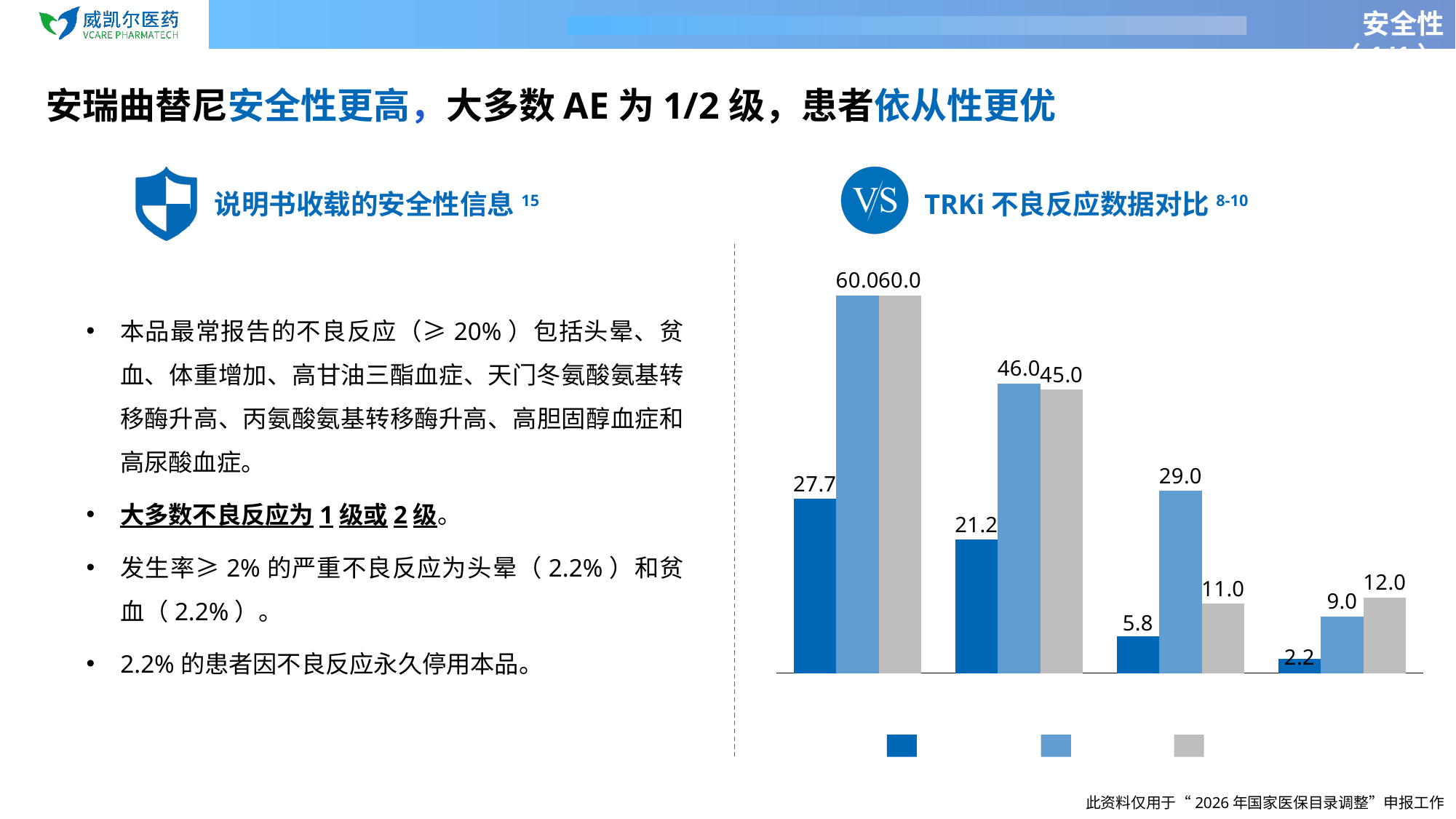
What is the difference between the light blue bar and the dark blue bar in the second group? 24.8 What is the title of the chart on the right side of the slide? TRKi 不良反应数据对比 How many series does the chart's legend list? 3 What is the value of the light blue bar in the third group? 29.0 Which group has the highest dark blue bar? the first (leftmost) group What is the value of the grey bar in the fourth (rightmost) group? 12.0 Which bar in the chart has the lowest value? the dark blue bar in the fourth group (2.2) What is the value of the dark blue bar in the first (leftmost) group? 27.7 How many groups of bars does the chart show? 4 What type of chart is shown on the right side of the slide? bar chart In the third group, which is larger, the light blue bar or the grey bar? the light blue bar Do the dark blue bars rise or fall from left to right across the groups? fall